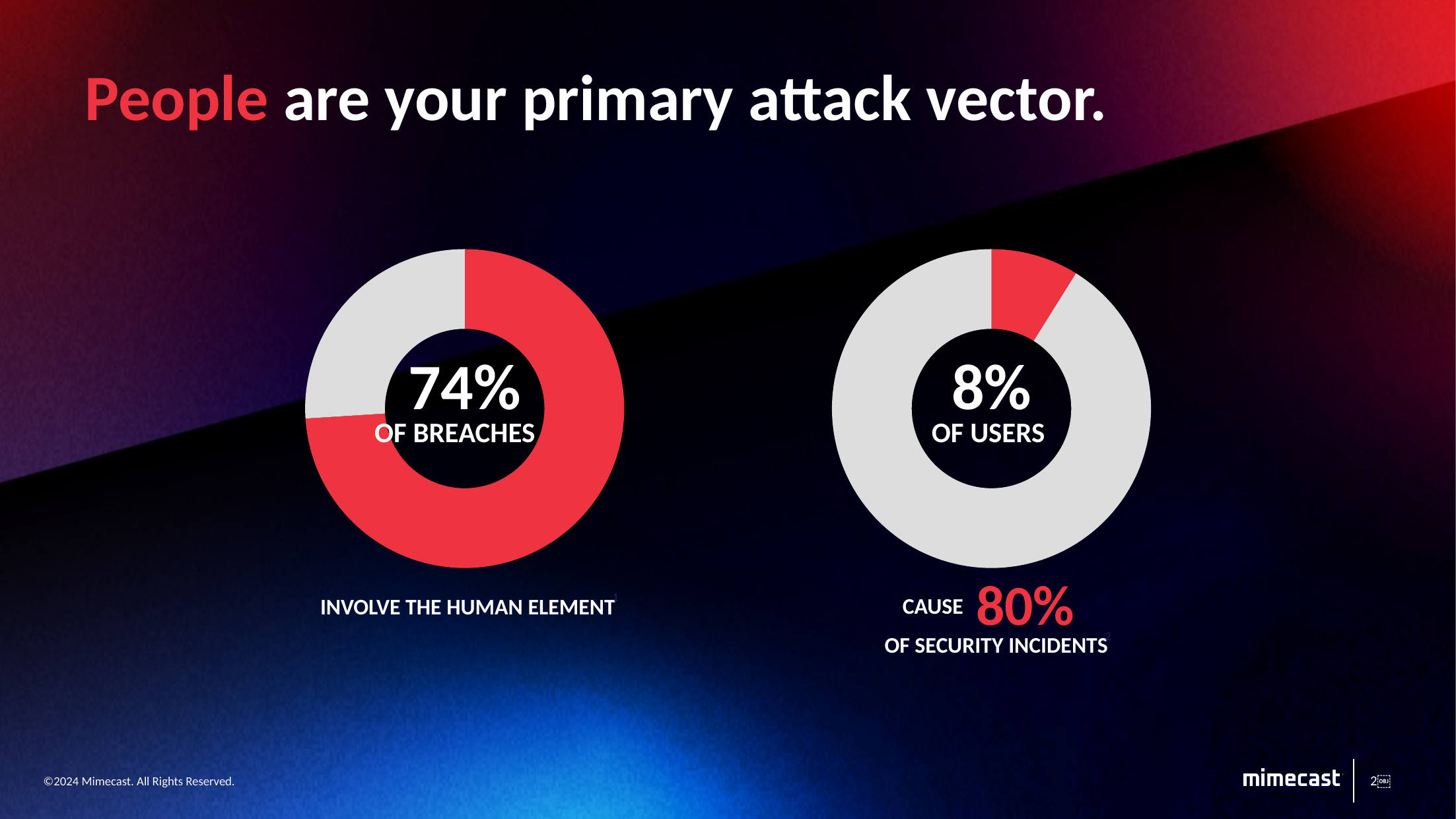
In the right chart, is the red slice greater or less than 25% of the ring? less According to the right chart's caption, what share of security incidents do 8% of users cause? 80% What kind of charts are shown on the slide? Donut (pie) charts What is the title of the slide? People are your primary attack vector. Which chart shows the larger highlighted (red) share: the left chart (of breaches) or the right chart (of users)? The left chart (74% of breaches) In the left chart, is the red slice greater or less than 50% of the ring? greater How many charts are on the slide? 2 What colour is used for the highlighted slice in both charts? Red In the right chart, what percentage of users is highlighted? 8% How many slices does the left chart have? 2 How many slices does the right chart have? 2 In the left chart, what percentage of breaches involve the human element? 74%